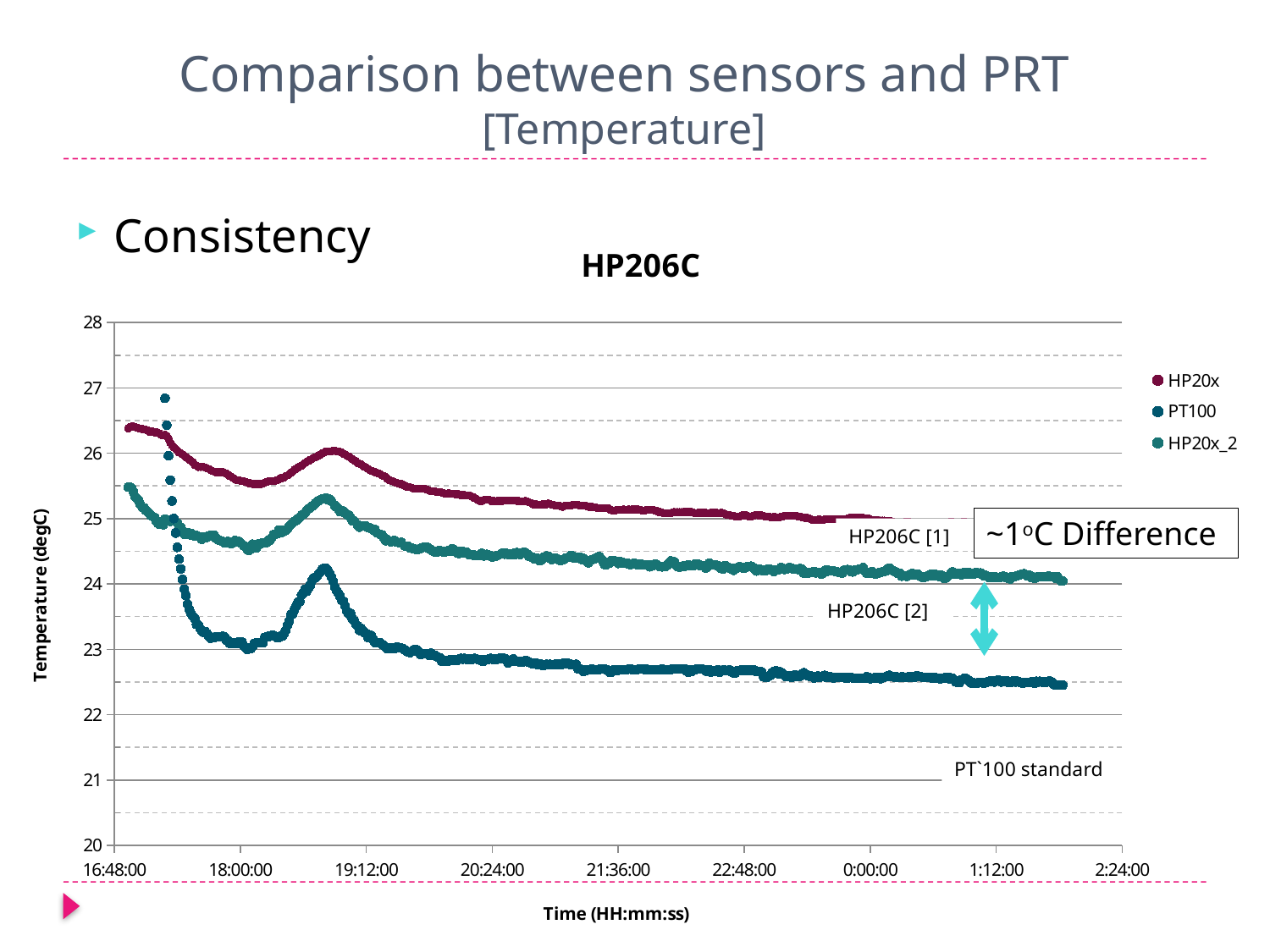
Is the PT100 value at 1:12:00 greater or less than 23? less Do the HP20x values generally rise or fall from 16:48:00 to the end of the series? fall At 21:36:00, which is larger: the HP20x_2 value or the PT100 value? HP20x_2 Is the HP20x value at 0:00:00 greater or less than 24? greater What is the label of the vertical axis? Temperature (degC) At 19:12:00, which is larger: the HP20x value or the PT100 value? HP20x What is the title of the chart? HP206C How many series does the legend list? 3 Which series has the highest temperature values across most of the time range? HP20x What kind of chart is shown on the slide? scatter chart At 0:00:00, which series has the lowest temperature? PT100 Is the HP20x_2 value at 1:12:00 greater or less than 25? less